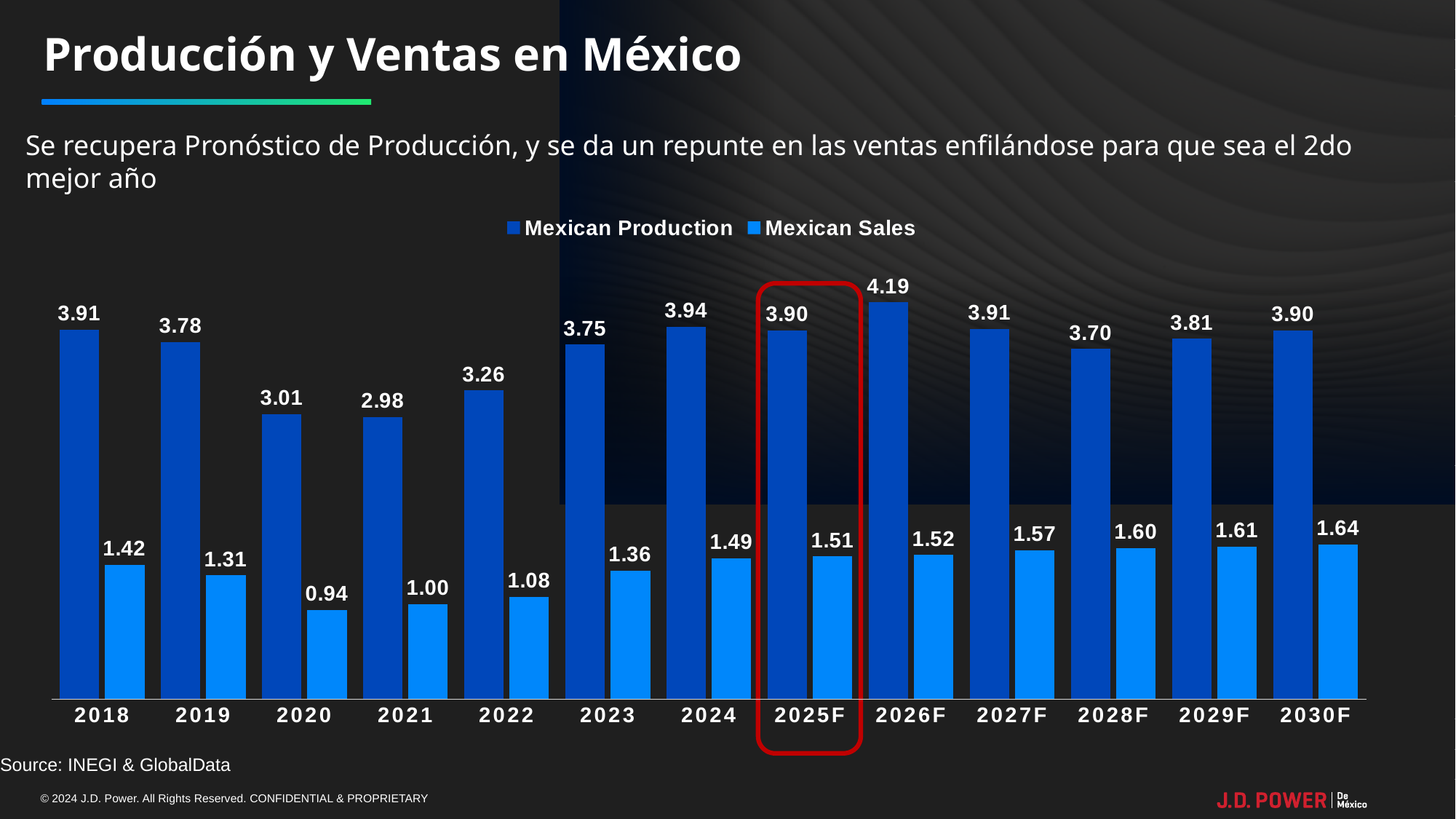
Which year has the highest Mexican Production value? 2026F What is the Mexican Sales value for 2020? 0.94 What kind of chart is shown on the slide? Bar chart How many series does the legend list? 2 Which year has the lowest Mexican Sales value? 2020 What is the difference between Mexican Production and Mexican Sales in 2026F? 2.67 How many years are shown on the x axis? 13 What is the Mexican Sales value for 2025F? 1.51 Which year has the lowest Mexican Production value? 2021 Which is larger, Mexican Production in 2024 or Mexican Production in 2022? 2024 What is the Mexican Production value for 2026F? 4.19 Do the Mexican Sales values rise or fall from 2020 to 2030F? Rise